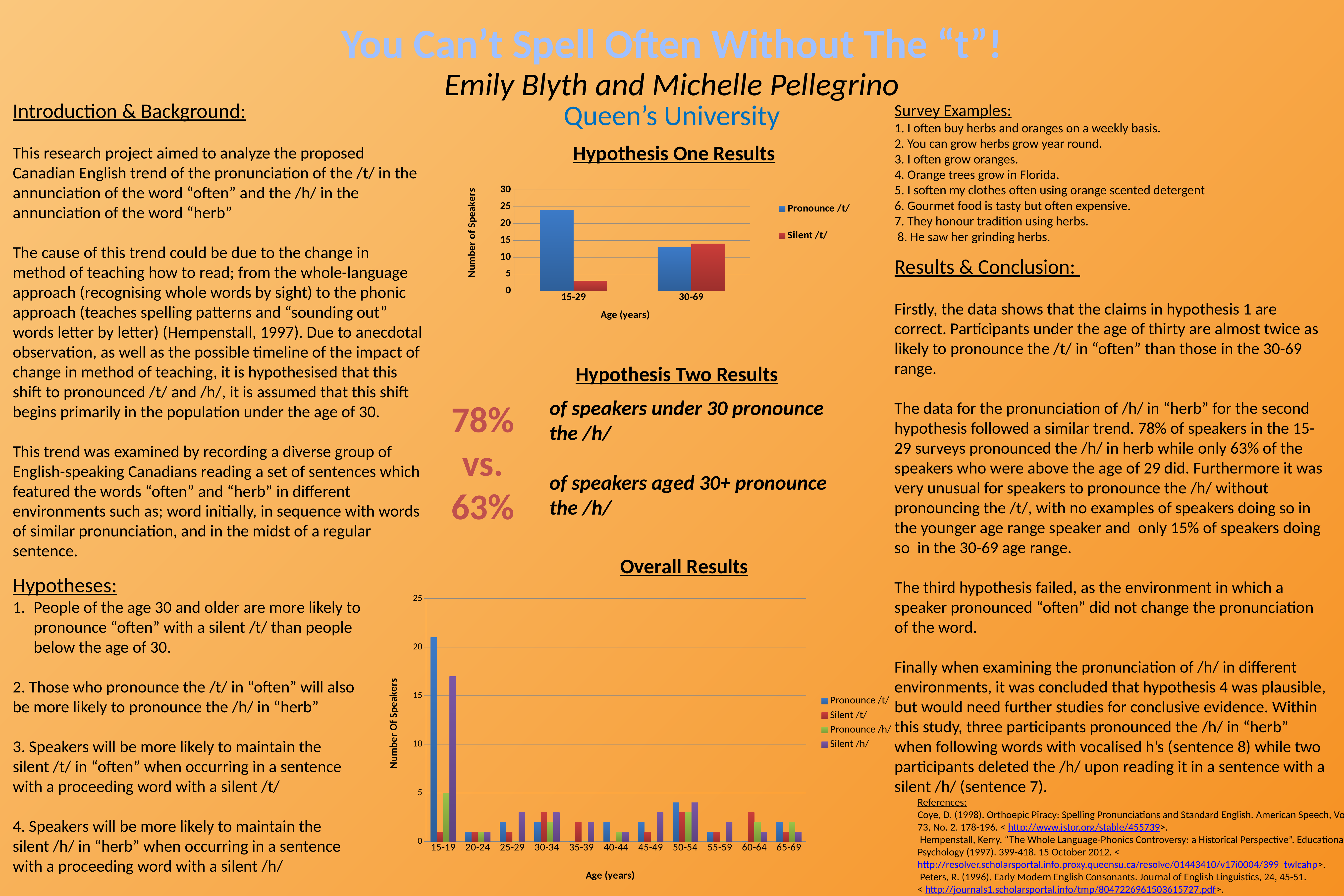
In the Hypothesis One Results chart, which is larger for the 15-29 group, Pronounce /t/ or Silent /t/? Pronounce /t/ In the Hypothesis One Results chart, is the value for Pronounce /t/ in the 15-29 group greater or less than 20? greater In the Overall Results chart, how many age categories are shown on the x axis? 11 In the Overall Results chart, how many series does the legend list? 4 In the Hypothesis One Results chart, what kind of chart is shown? bar chart In the Hypothesis One Results chart, what is the label of the y axis? Number of Speakers In the Hypothesis One Results chart, is the value for Silent /t/ in the 15-29 group greater or less than 5? less In the Hypothesis One Results chart, how many series does the legend list? 2 In the Overall Results chart, which is larger for the 15-19 group, Pronounce /h/ or Silent /h/? Silent /h/ In the Overall Results chart, which age group has the highest Pronounce /t/ value? 15-19 In the Overall Results chart, is the value for Silent /h/ in the 15-19 group greater or less than 15? greater In the Hypothesis One Results chart, how many age categories are shown on the x axis? 2